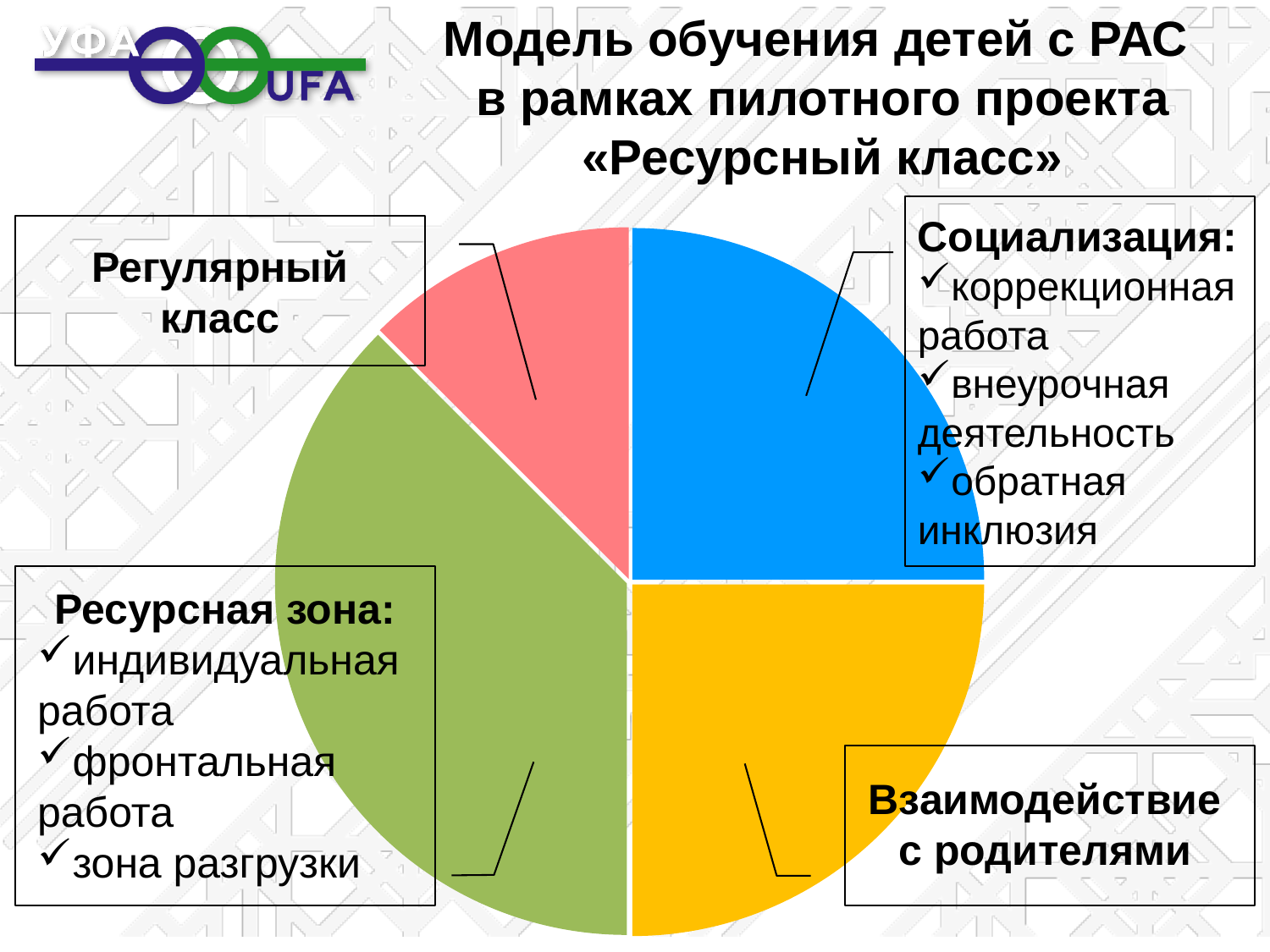
Which slice of the pie chart is the largest? Ресурсная зона Which slice of the pie chart is the smallest? Регулярный класс Which slice is larger: Ресурсная зона or Регулярный класс? Ресурсная зона What kind of chart is shown on the slide? pie chart What colour is the slice labelled Социализация? blue Which slice is larger: Ресурсная зона or Социализация? Ресурсная зона Which slice is larger: Взаимодействие с родителями or Регулярный класс? Взаимодействие с родителями How many slices does the pie chart have? 4 Which slice of the pie chart is coloured yellow? Взаимодействие с родителями